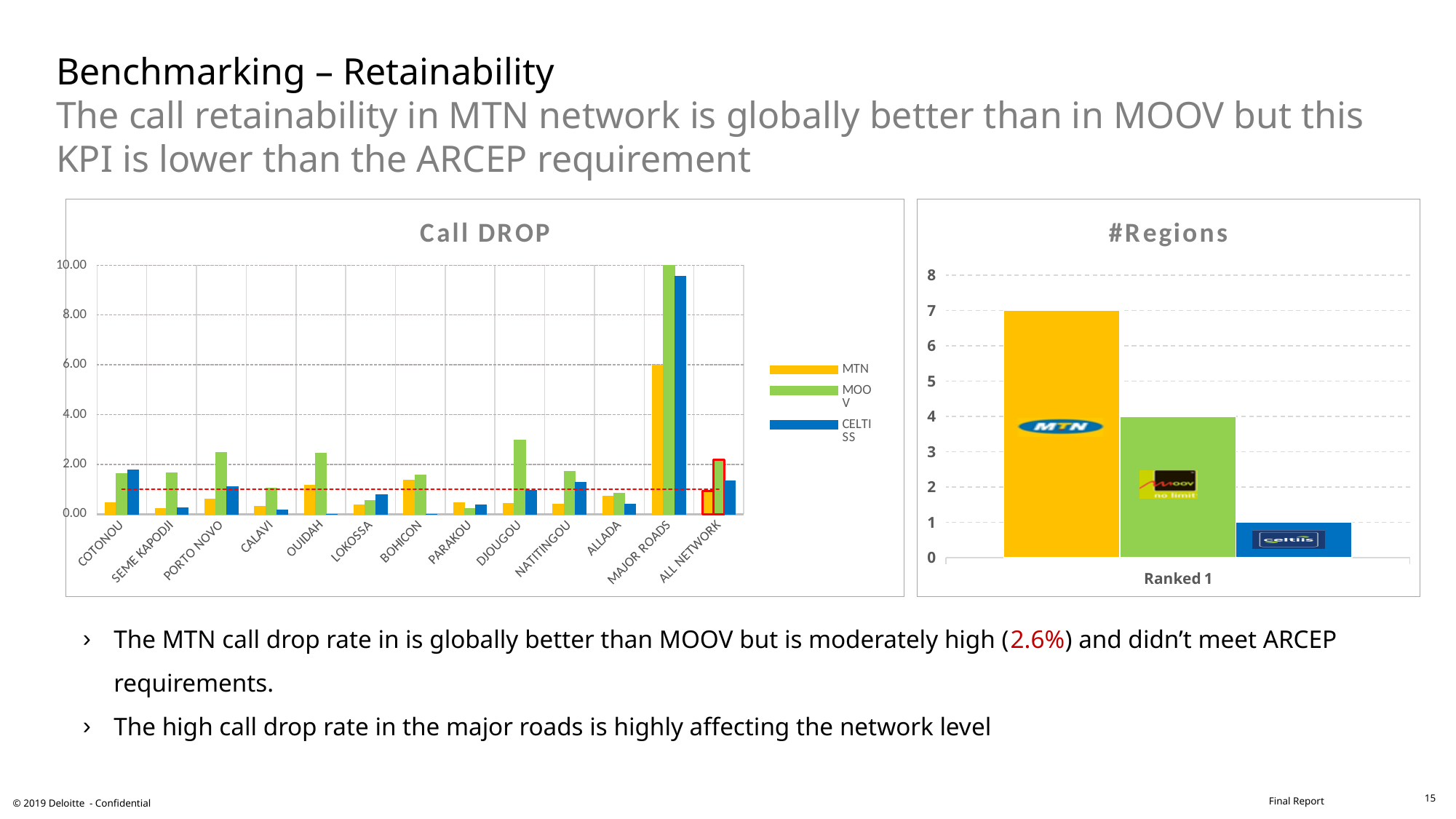
In the Call DROP chart, is the MOOV value for MAJOR ROADS greater or less than 8.00? greater In the Call DROP chart, which is larger for PORTO NOVO, the MTN value or the MOOV value? MOOV How many series does the legend of the Call DROP chart list? 3 In the Call DROP chart, which category has the highest MOOV value? MAJOR ROADS In the #Regions chart, what is the value of the MTN bar? 7 In the Call DROP chart, is the MOOV value for DJOUGOU greater or less than 2.00? greater What kind of chart is the Call DROP chart? bar chart How many categories are shown on the x axis of the Call DROP chart? 13 In the Call DROP chart, what are the three legend entries? MTN, MOOV, CELTISS In the #Regions chart, what is the difference between the MTN bar and the MOOV bar? 3 In the Call DROP chart, is the MTN value for MAJOR ROADS greater or less than 4.00? greater In the #Regions chart, which operator has the lowest bar? Celtis